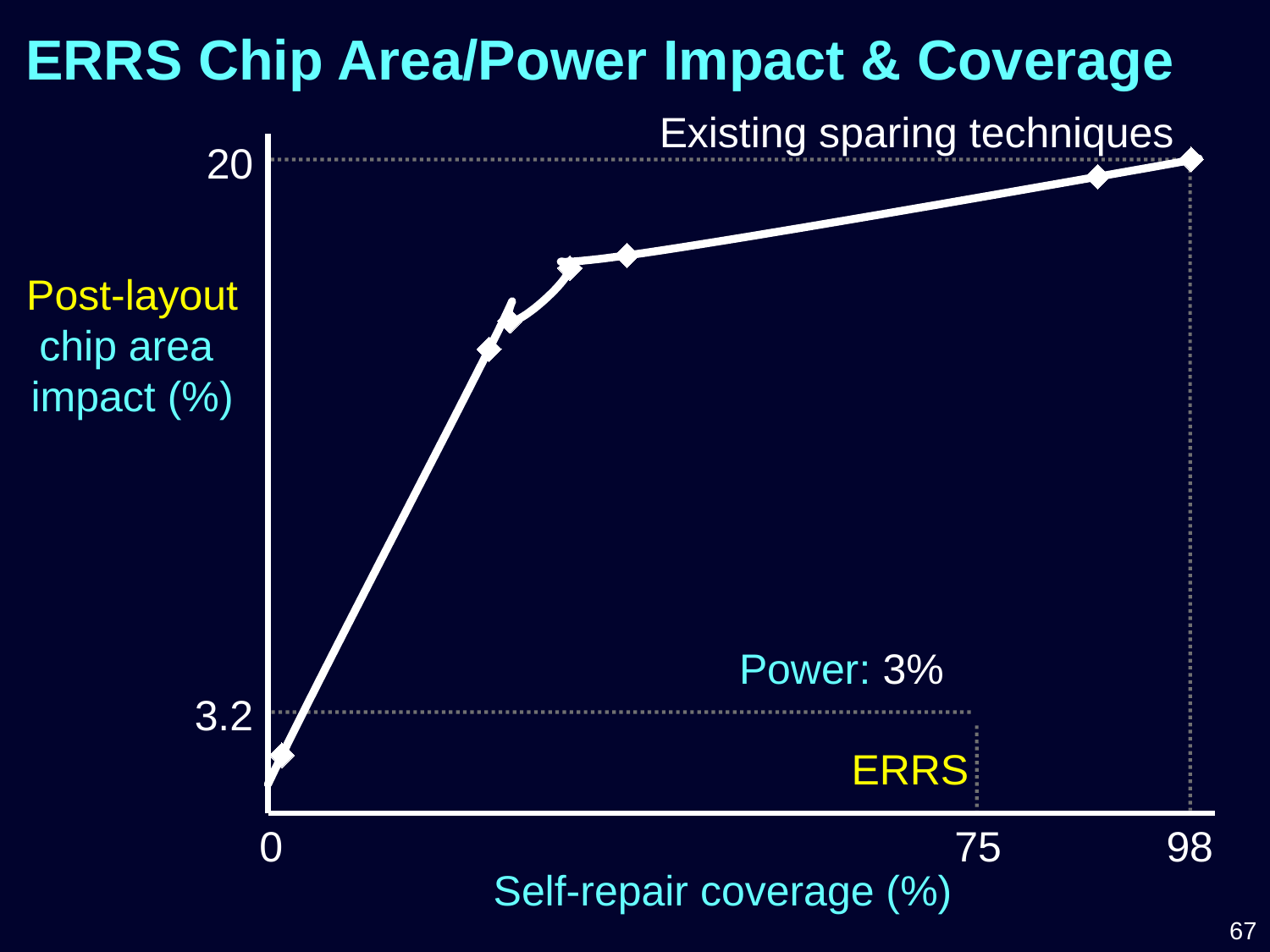
What self-repair coverage is marked for existing sparing techniques? 98 Does the chip area impact rise or fall as self-repair coverage increases along the x axis? rise Is the chip area impact at 75% self-repair coverage greater or less than 20? less What self-repair coverage is marked for ERRS? 75 What post-layout chip area impact is marked for ERRS? 3.2 What kind of chart is shown on the slide? line chart What is the label of the x axis? Self-repair coverage (%) Which has the larger chip area impact, ERRS or existing sparing techniques? Existing sparing techniques What power impact is stated for ERRS? 3% What post-layout chip area impact is marked for existing sparing techniques? 20 What is the difference in chip area impact between existing sparing techniques (20) and ERRS (3.2)? 16.8 What is the title of the chart on the slide? ERRS Chip Area/Power Impact & Coverage